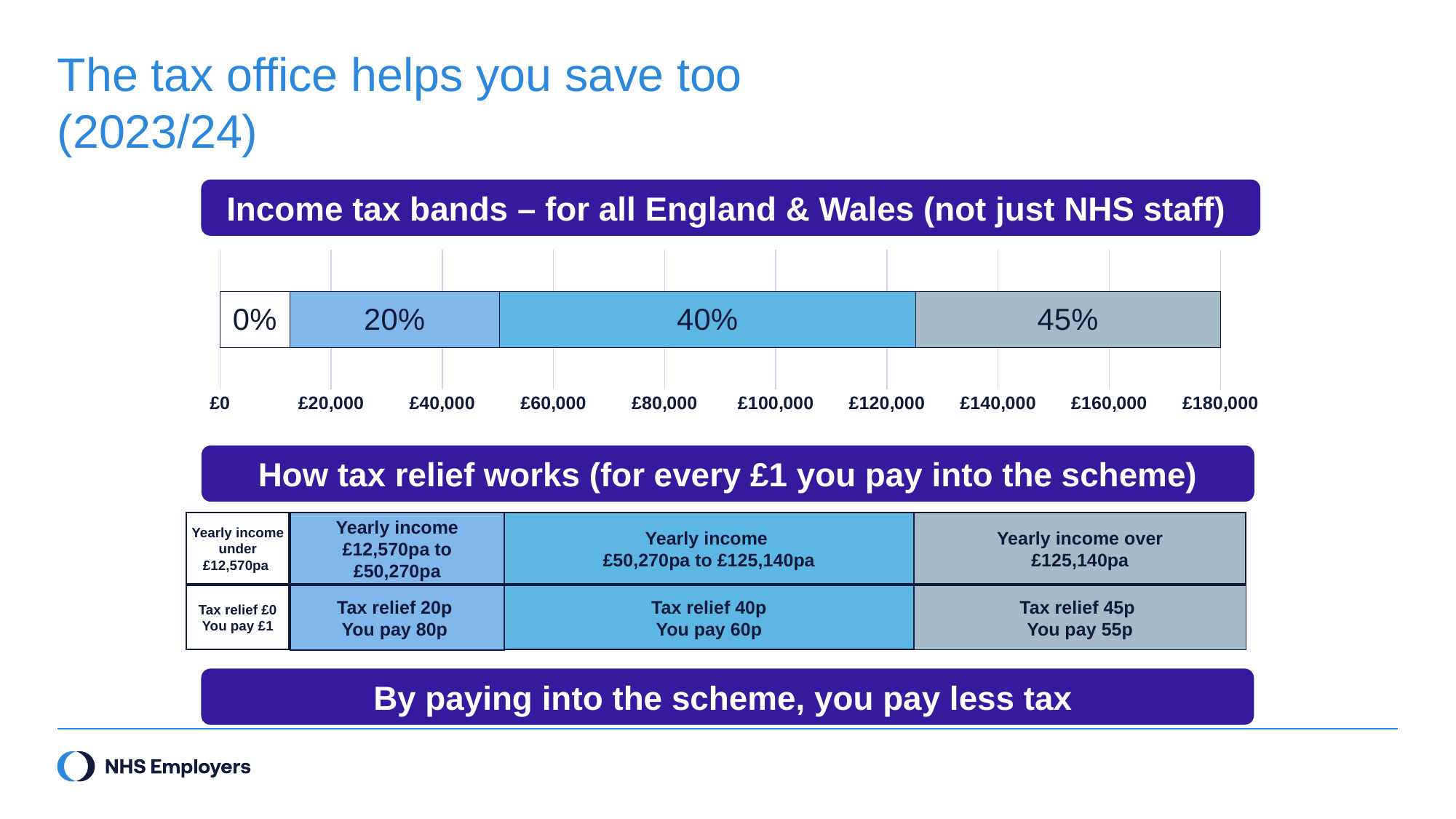
How many tax rate segments are shown in the income tax bands bar? 4 What kind of chart is used to show the income tax bands? Bar chart Is the upper boundary of the 20% band greater or less than £60,000 on the income axis? less Which tax band segment covers the widest range of income on the bar? 40% What is the lowest tax rate labelled on the income tax bands bar? 0% Is the upper boundary of the 40% band greater or less than £120,000 on the income axis? greater What is the maximum value shown on the income axis of the tax bands chart? £180,000 According to the income tax bands bar, what tax rate applies at a yearly income of £150,000? 45% Which tax band segment covers the narrowest range of income on the bar? 0% According to the income tax bands bar, what tax rate applies at a yearly income of £80,000? 40% What is the title of the chart above the income axis? Income tax bands – for all England & Wales (not just NHS staff) What is the highest tax rate labelled on the income tax bands bar? 45%